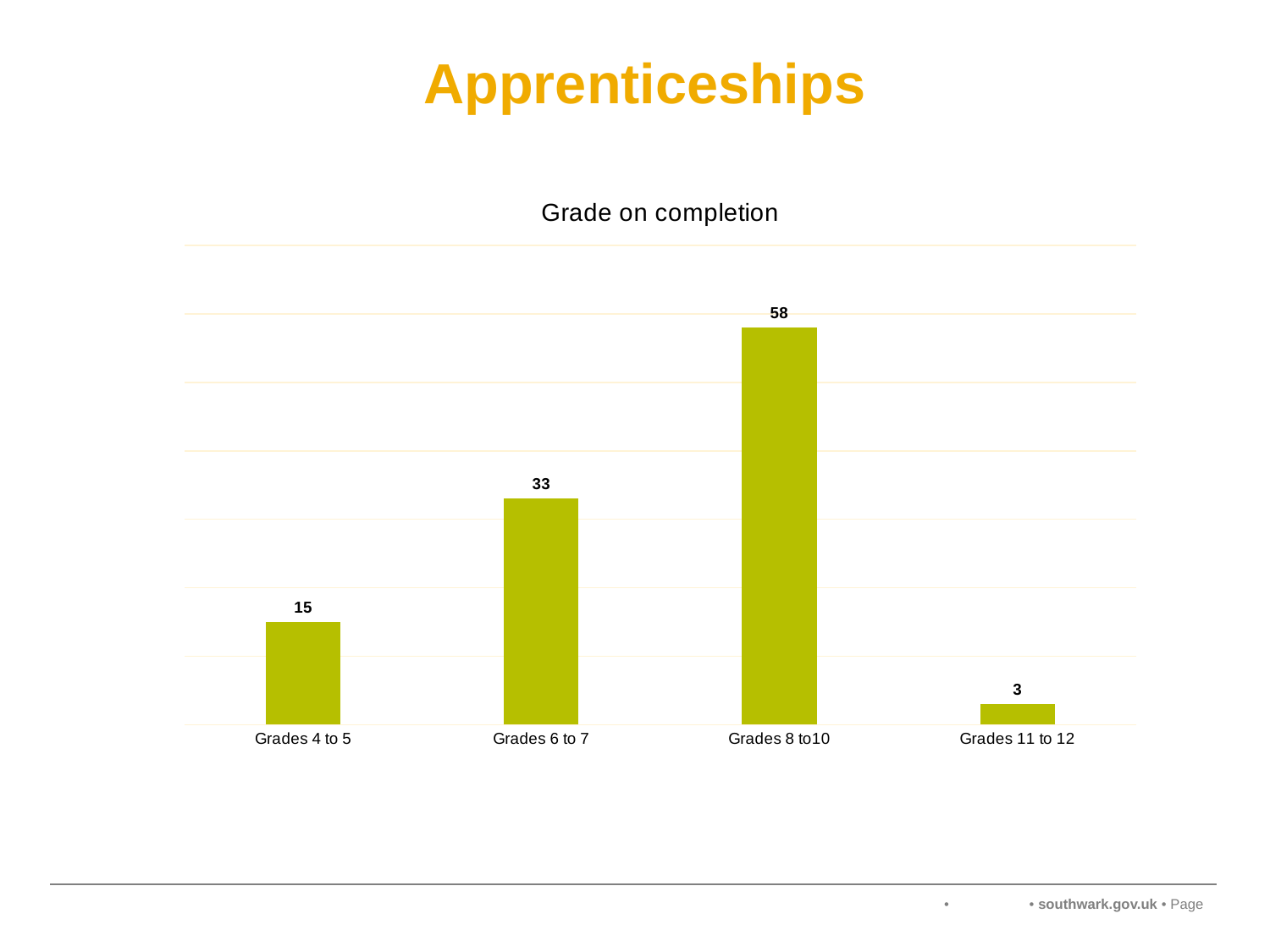
What is the value for Grades 4 to 5? 15 Which category has the highest value? Grades 8 to10 What is the value for Grades 8 to10? 58 What is the value for Grades 6 to 7? 33 What is the title of the chart? Grade on completion What is the difference between the values for Grades 4 to 5 and Grades 11 to 12? 12 What kind of chart is shown on the slide? Bar chart What is the value for Grades 11 to 12? 3 Which category has the lowest value? Grades 11 to 12 What is the difference between the values for Grades 8 to10 and Grades 6 to 7? 25 How many categories are shown on the x axis? 4 Which is larger, the value for Grades 6 to 7 or the value for Grades 4 to 5? Grades 6 to 7